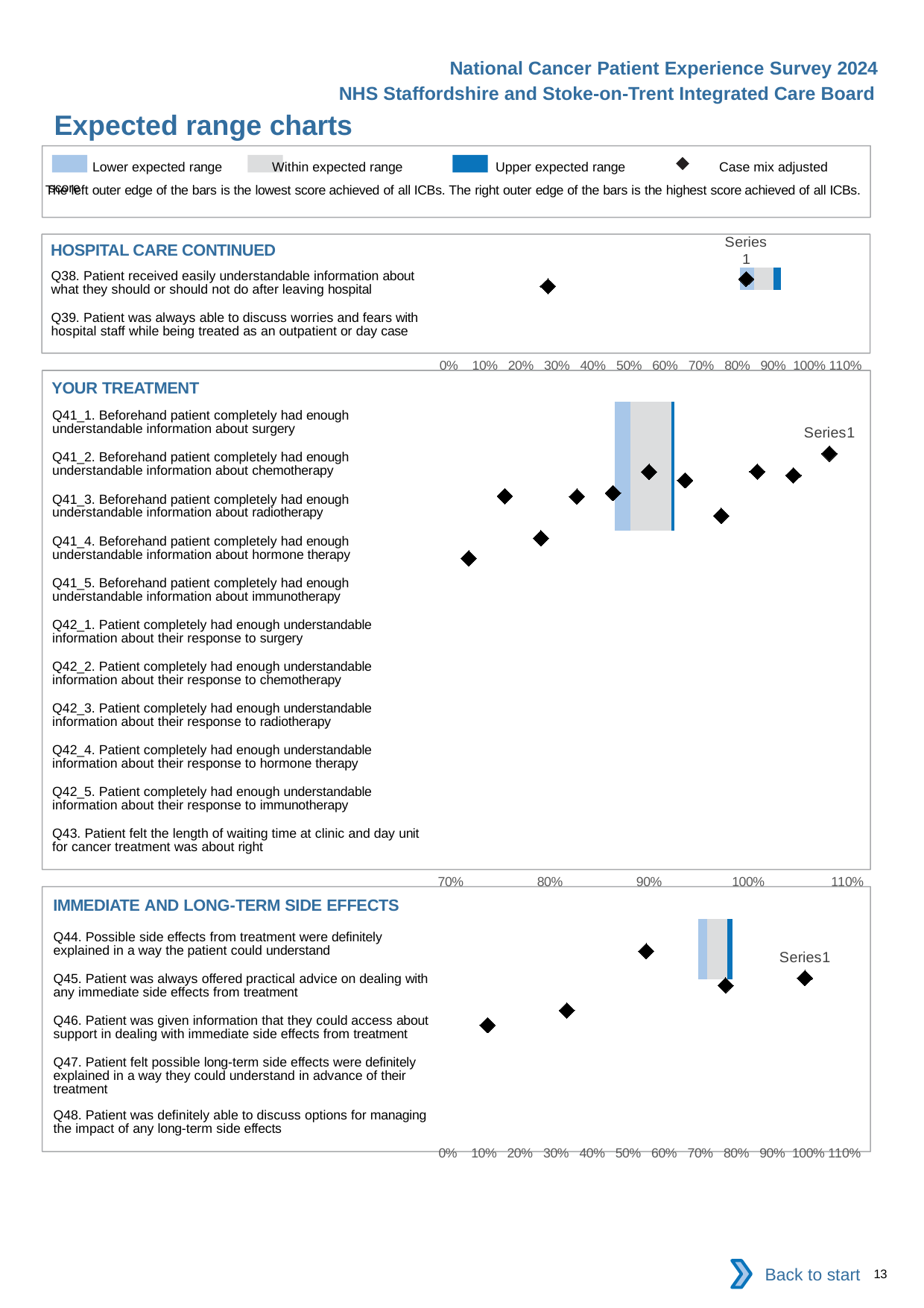
How many diamond markers are plotted in the YOUR TREATMENT chart? 11 What is the lowest value shown on the x axis of the YOUR TREATMENT chart? 70% How many diamond markers are plotted in the IMMEDIATE AND LONG-TERM SIDE EFFECTS chart? 5 How many entries does the legend at the top of the slide list? 4 How many questions are listed in the IMMEDIATE AND LONG-TERM SIDE EFFECTS chart? 5 In the legend at the top of the slide, what does the diamond symbol represent? Case mix adjusted score What is the highest value shown on the x axis of the IMMEDIATE AND LONG-TERM SIDE EFFECTS chart? 110%